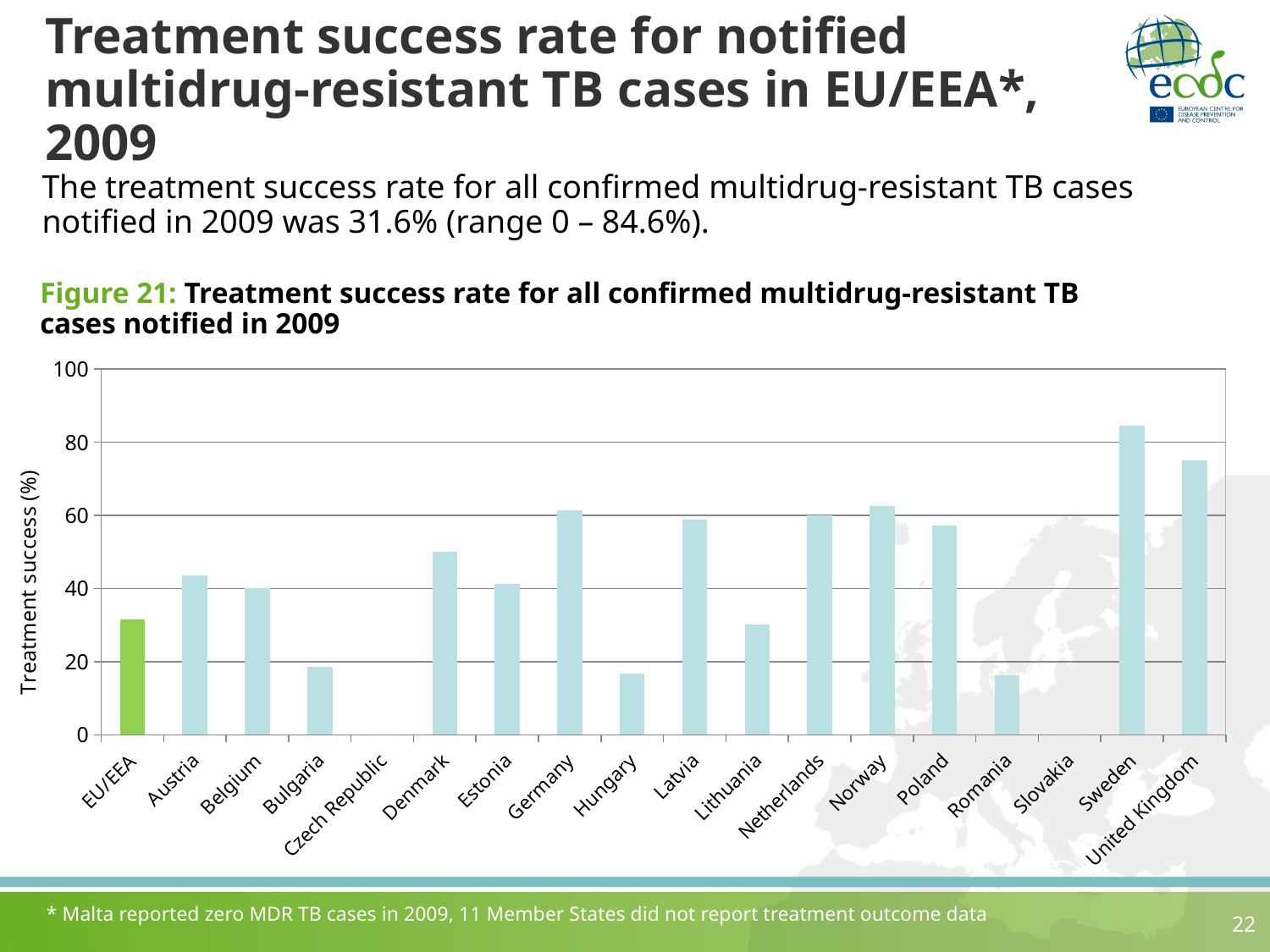
What is the treatment success rate shown for EU/EEA? 31.6% Is the value for United Kingdom greater or less than 80? less How many categories are shown along the x axis of the chart? 18 Is the value for Hungary greater or less than 20? less What is the label of the y axis of the chart? Treatment success (%) Is the value for Bulgaria greater or less than 20? less Which category has the highest treatment success rate in the chart? Sweden Which has a higher treatment success rate, Germany or Hungary? Germany Which has a higher treatment success rate, Sweden or United Kingdom? Sweden What kind of chart is shown in Figure 21? bar chart